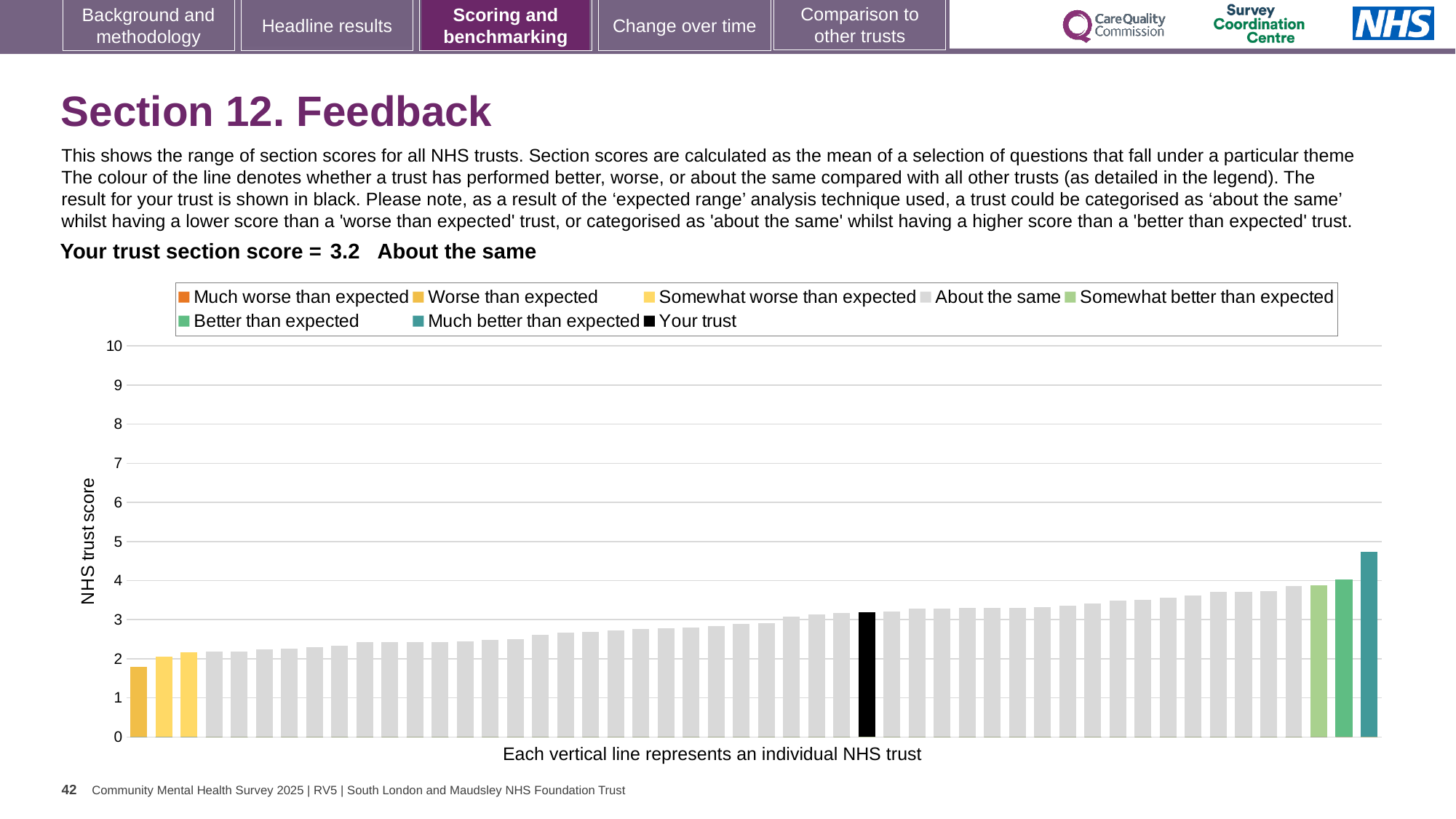
Is the value of the shortest bar (leftmost) greater or less than 2? less Is the value of the black bar (your trust) greater or less than 3? greater How many entries does the chart legend list? 8 Which category is your trust's section score placed in? About the same Is the value of the black bar (your trust) greater or less than 4? less What is the label on the vertical axis? NHS trust score What is the section score for your trust? 3.2 Do the bar values rise or fall from left to right along the x axis? rise What is the highest value shown on the vertical axis? 10 Which legend category does the tallest bar belong to? Much better than expected What kind of chart is shown on the slide? bar chart